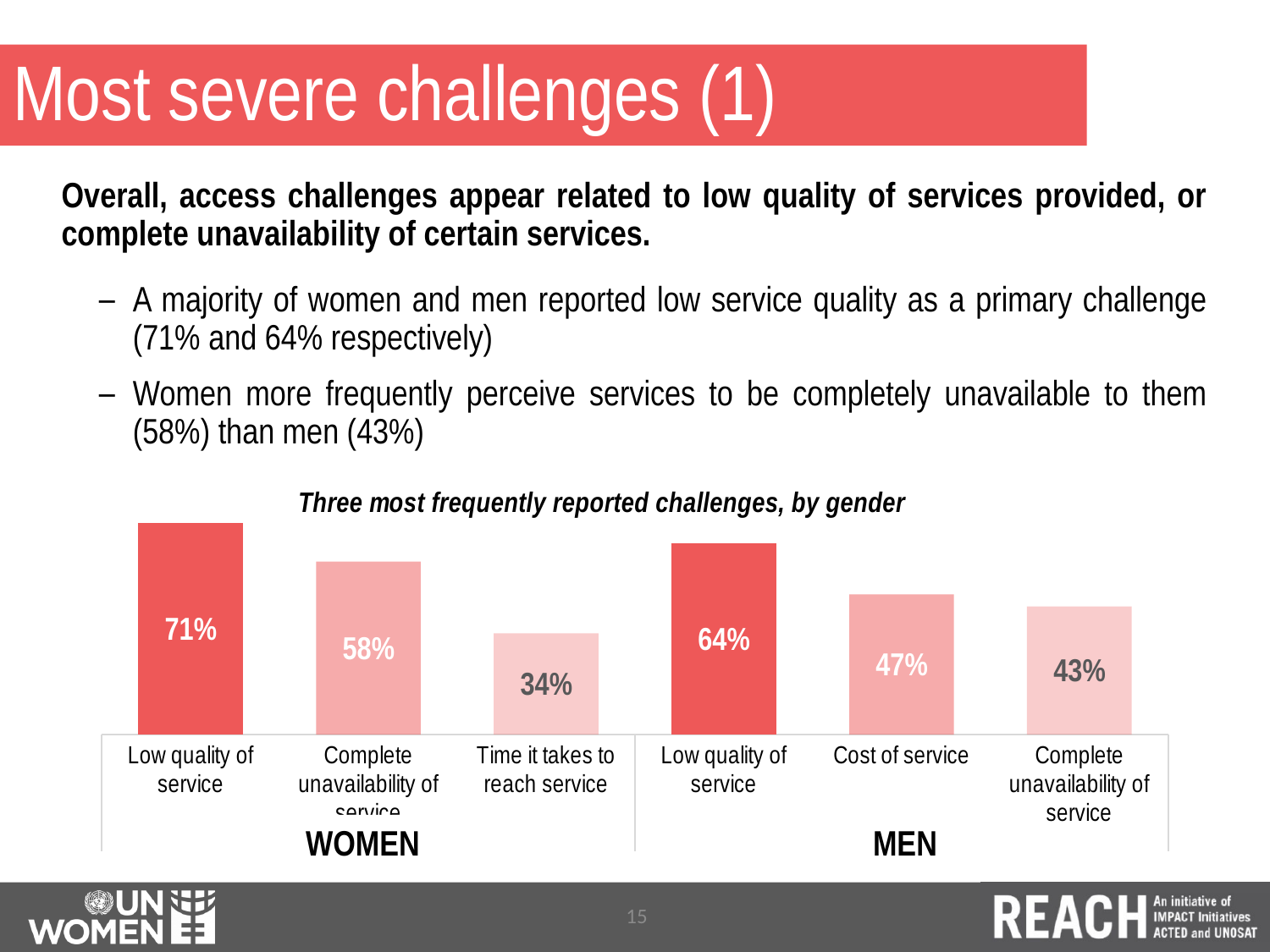
What percentage of men reported complete unavailability of service as a challenge? 43% What is the difference between the women's and men's values for complete unavailability of service? 15% What percentage of men reported cost of service as a challenge? 47% What is the title of the chart? Three most frequently reported challenges, by gender What percentage of women reported low quality of service as a challenge? 71% What percentage of women reported time it takes to reach service as a challenge? 34% Which challenge has the lowest value among women? Time it takes to reach service Which is larger: the women's value for complete unavailability of service or the men's value for cost of service? Women's complete unavailability of service Which challenge has the highest value among men? Low quality of service What is the difference between the women's and men's values for low quality of service? 7% How many bars are shown in the chart in total? 6 What type of chart is shown on the slide? Bar chart